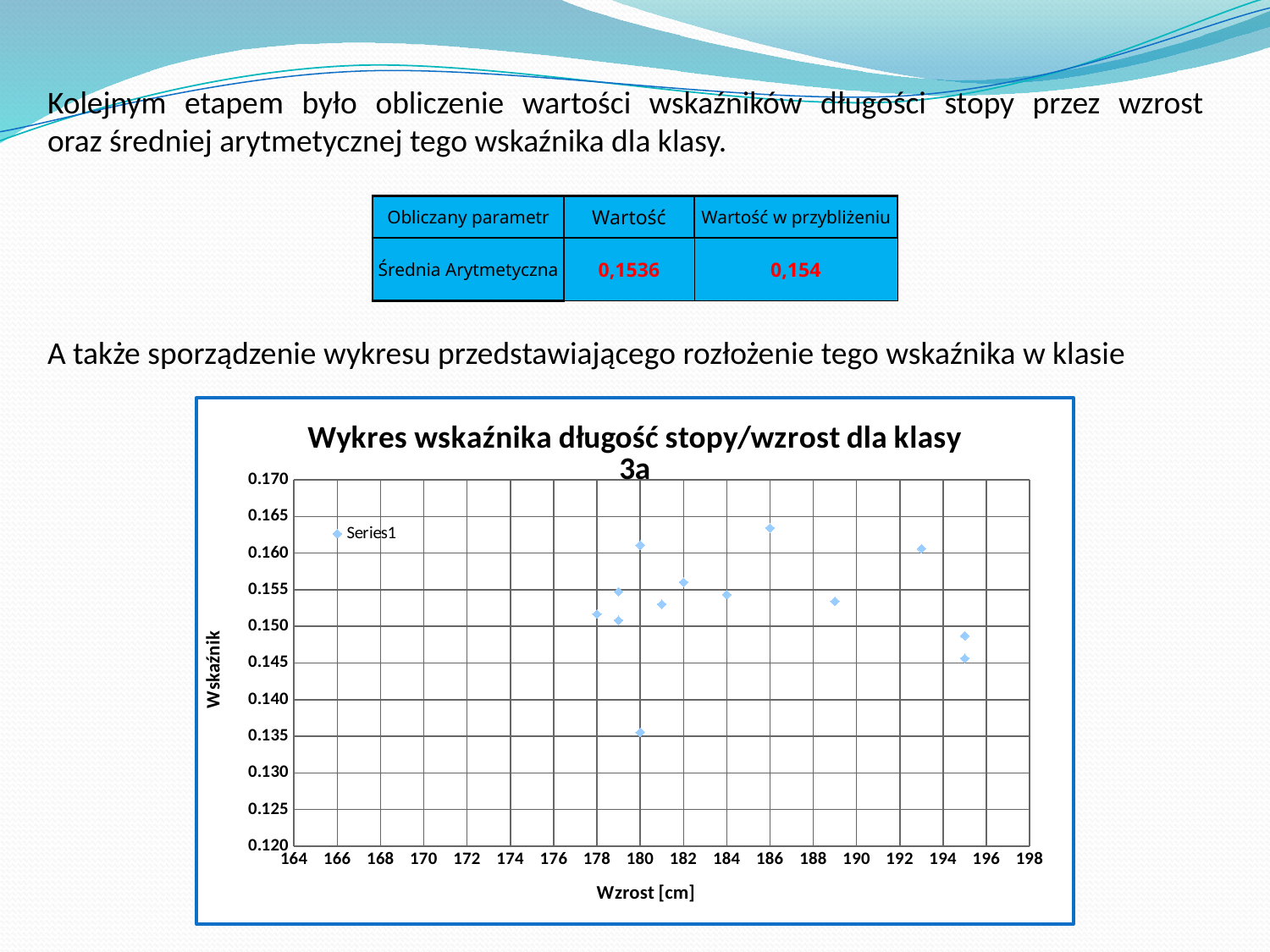
What is the title of the chart? Wykres wskaźnika długość stopy/wzrost dla klasy 3a Is the index value plotted at a height of 186 cm greater or less than 0.160? greater Is the index value plotted at a height of 178 cm greater or less than 0.160? less Is the lowest plotted index value greater or less than 0.140? less What kind of chart is shown on the slide? scatter chart Which has the higher index value: the point at 193 cm or the point at 189 cm? 193 cm At which height (Wzrost) is the lowest plotted index value? 180